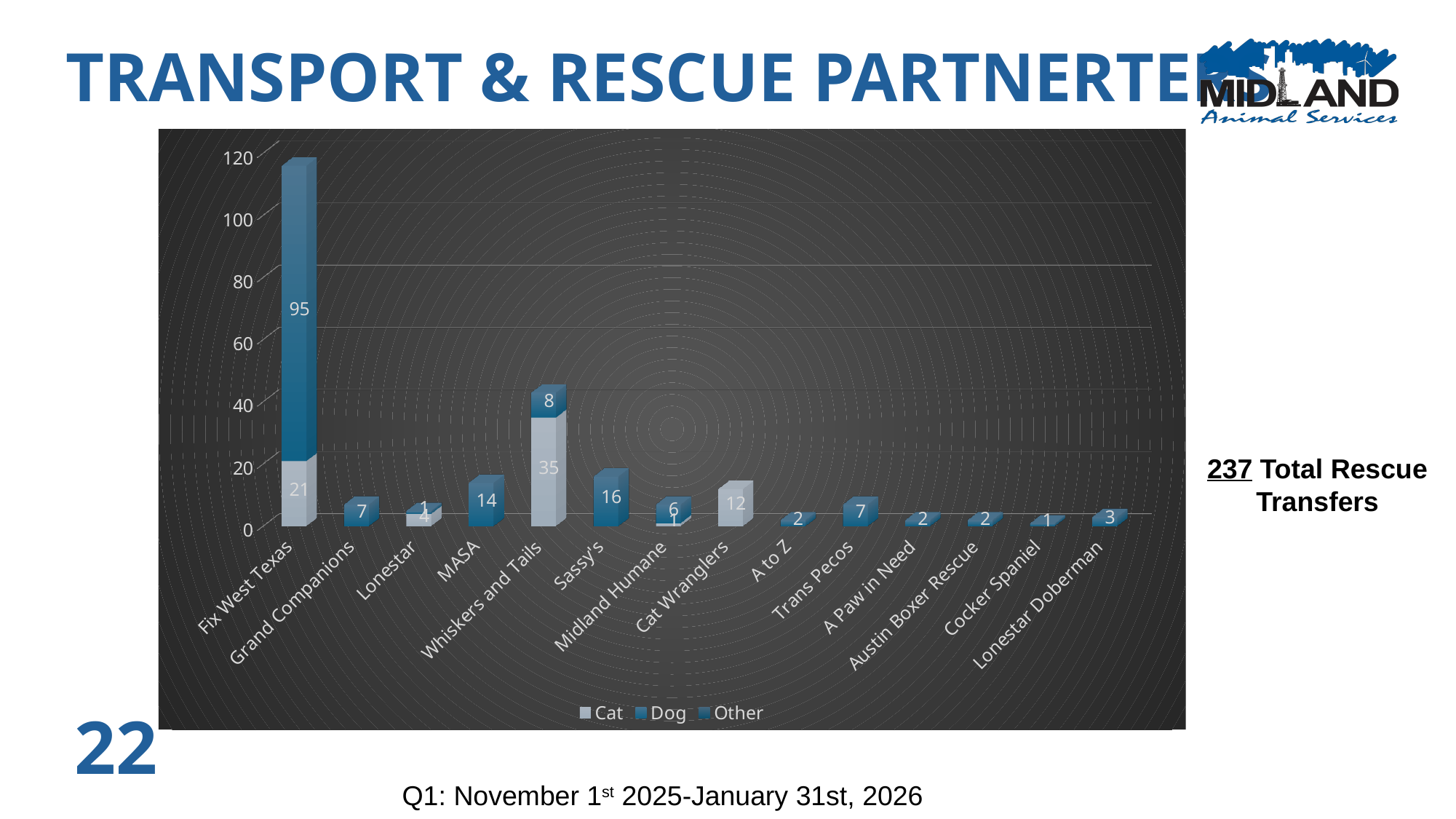
What is the total of the stacked bar for Whiskers and Tails? 43 What is the difference between the Dog value for Fix West Texas and the Cat value for Fix West Texas? 74 What is the Dog value for Fix West Texas? 95 What is the total of the stacked bar for Fix West Texas? 116 How many series does the legend list? 3 What kind of chart is shown on the slide? Stacked bar chart Which partner has the tallest stacked bar? Fix West Texas How many partner categories are shown on the x axis? 14 What is the Cat value for Cat Wranglers? 12 Which is larger, the Dog value for MASA or the Dog value for Sassy's? Sassy's What is the Cat value for Whiskers and Tails? 35 What is the Dog value for Sassy's? 16